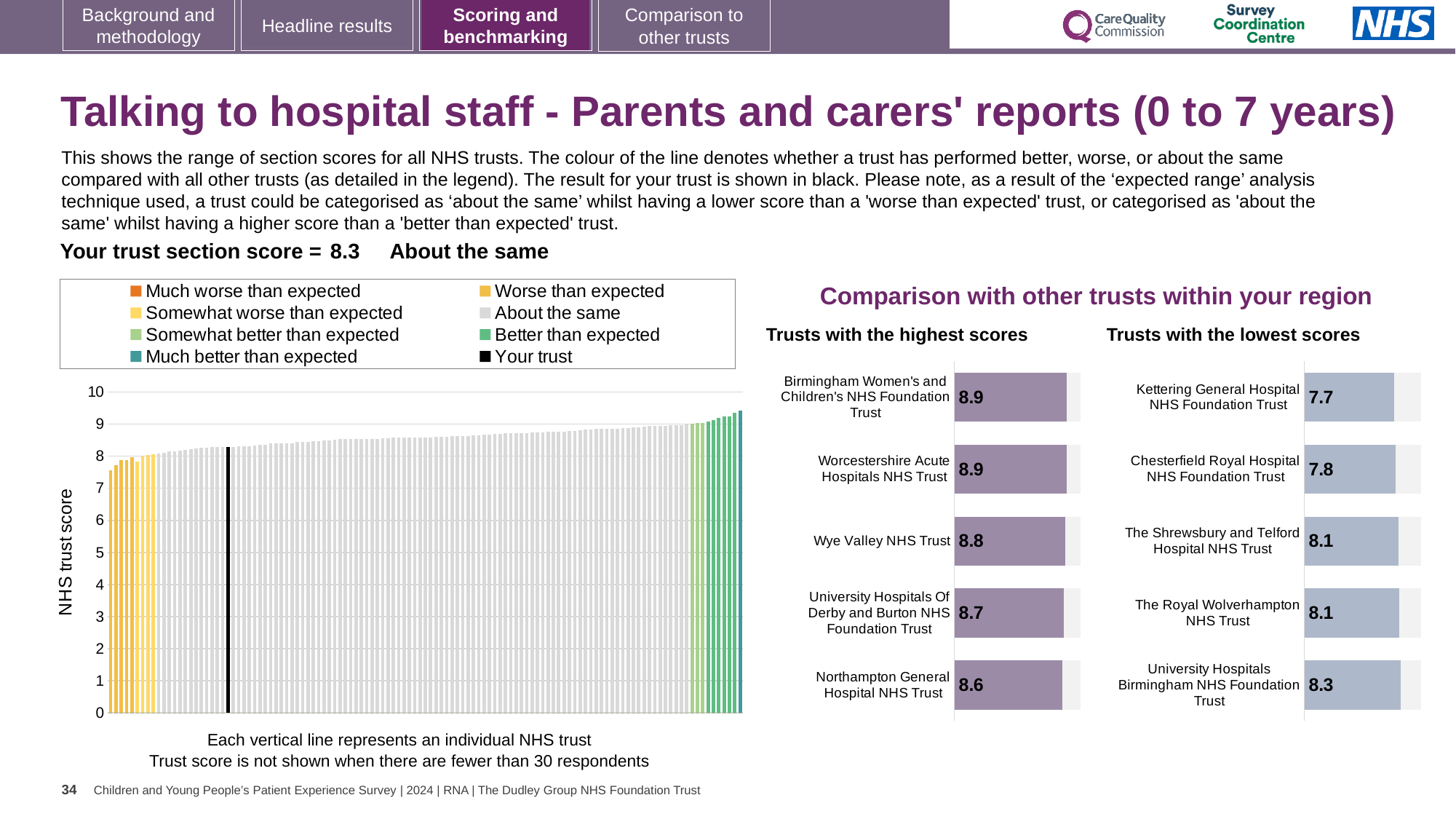
How many trusts are listed in the 'Trusts with the highest scores' chart? 5 In the main 'NHS trust score' chart on the left, is the value for the black 'Your trust' bar greater or less than 9? less In the main 'NHS trust score' chart on the left, do the trust scores rise or fall from left to right? rise In the 'Trusts with the lowest scores' chart, which trust has the highest score? University Hospitals Birmingham NHS Foundation Trust In the 'Trusts with the lowest scores' chart, which trust has the lowest score? Kettering General Hospital NHS Foundation Trust In the 'Trusts with the lowest scores' chart, what is the difference between the scores of University Hospitals Birmingham NHS Foundation Trust and Kettering General Hospital NHS Foundation Trust? 0.6 In the 'Trusts with the lowest scores' chart, which has the higher score: Chesterfield Royal Hospital NHS Foundation Trust or The Shrewsbury and Telford Hospital NHS Trust? The Shrewsbury and Telford Hospital NHS Trust How many entries does the legend of the main 'NHS trust score' chart list? 8 In the 'Trusts with the highest scores' chart, which trust has the lowest score? Northampton General Hospital NHS Trust In the 'Trusts with the lowest scores' chart, what is the score for Chesterfield Royal Hospital NHS Foundation Trust? 7.8 In the 'Trusts with the highest scores' chart, what is the score for Wye Valley NHS Trust? 8.8 In the 'Trusts with the highest scores' chart, what is the difference between the scores of Birmingham Women's and Children's NHS Foundation Trust and Northampton General Hospital NHS Trust? 0.3